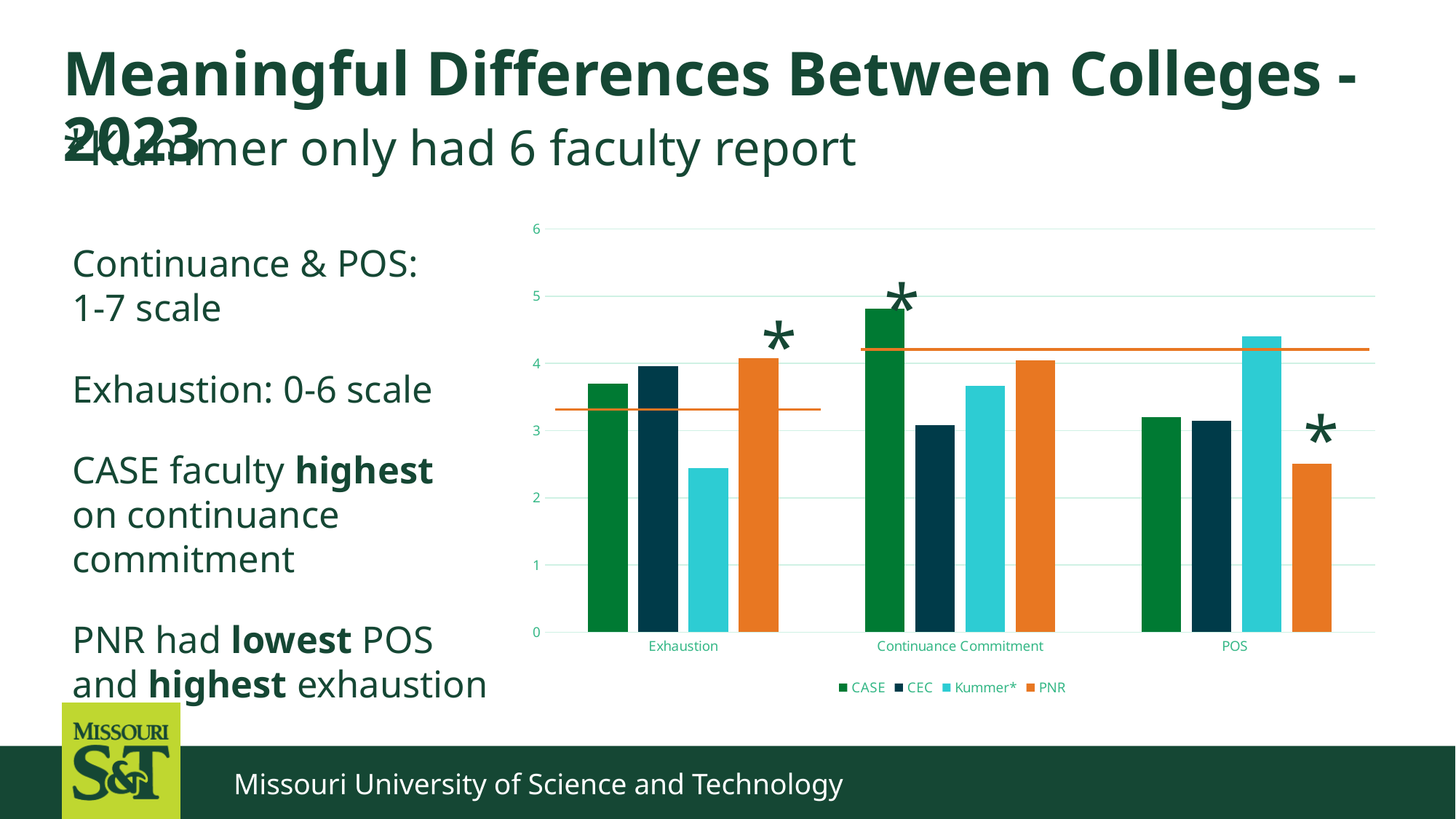
Is the value for CASE in Continuance Commitment greater or less than 4? greater Which series has the lowest bar in the POS category? PNR How many series does the chart's legend list? 4 What kind of chart is shown on the slide? bar chart Which series has the highest bar in the Continuance Commitment category? CASE In the Continuance Commitment category, which is larger: the CEC bar or the PNR bar? PNR Which series is shown in orange in the chart's legend? PNR Which series has the lowest bar in the Exhaustion category? Kummer* How many categories are shown on the x axis of the chart? 3 Is the value for PNR in POS greater or less than 3? less Is the value for Kummer* in Exhaustion greater or less than 3? less Which series has the highest bar in the POS category? Kummer*